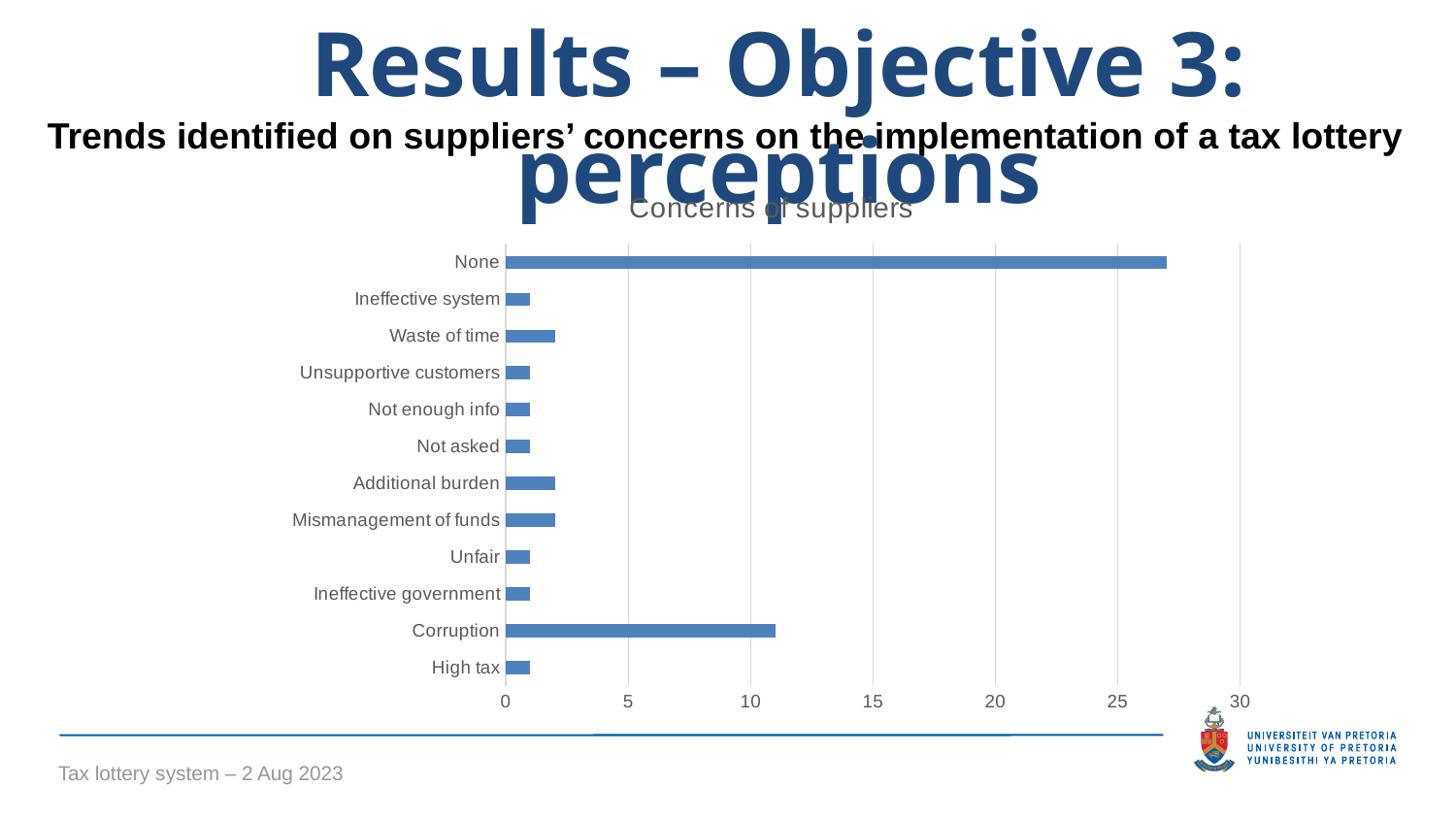
What kind of chart is shown on the slide? bar chart What is the title of the chart? Concerns of suppliers Which is larger, the value for None or the value for Corruption? None Is the value for None greater or less than 25? greater Which is larger, the value for Corruption or the value for Additional burden? Corruption Is the value for Corruption greater or less than 10? greater How many categories are plotted in the chart? 12 Is the value for High tax greater or less than 5? less Which category has the highest value in the chart? None Which category has the second-highest value in the chart? Corruption